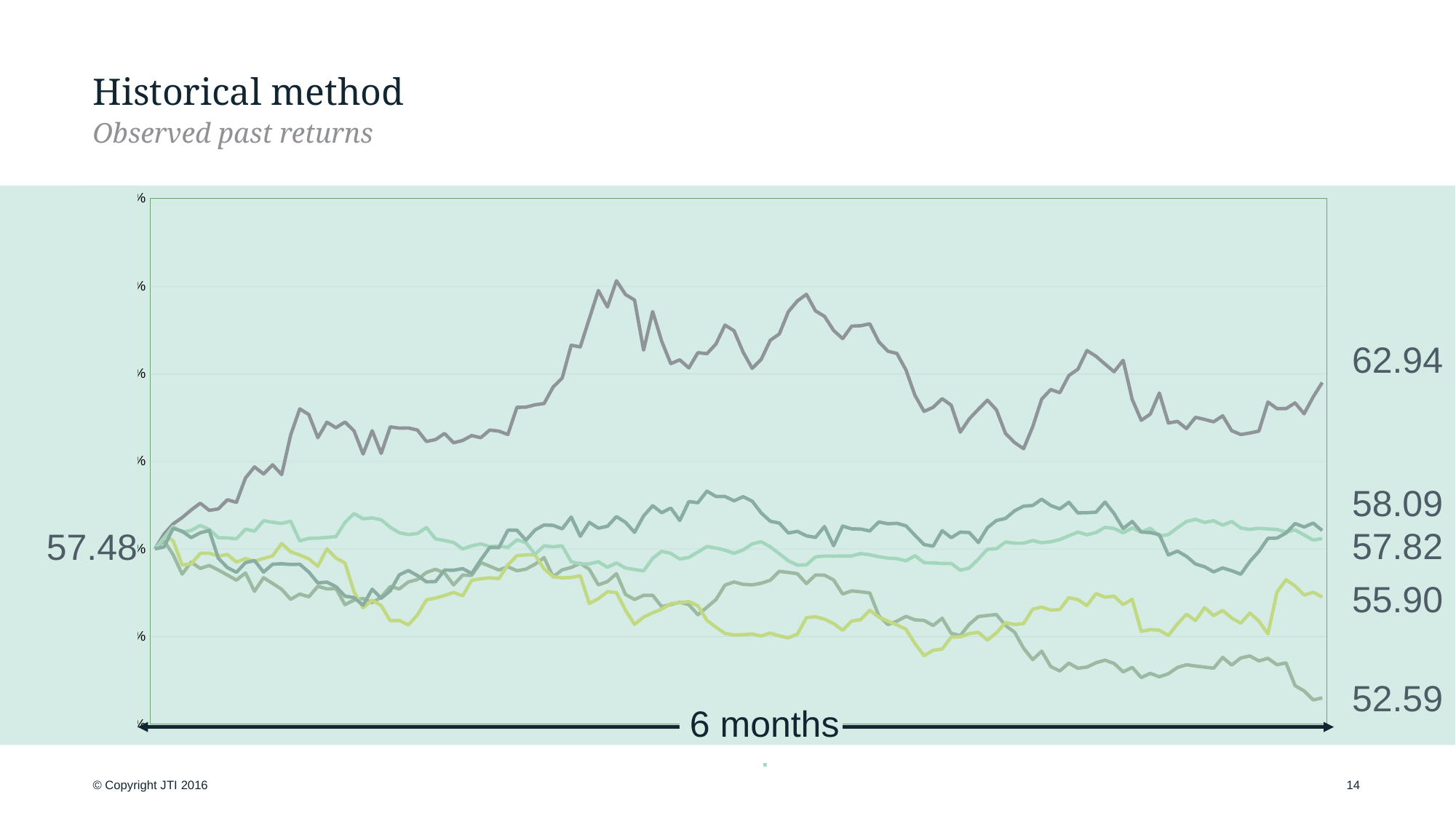
What time span does the horizontal arrow under the chart indicate? 6 months What is the highest end value labelled on the right of the chart? 62.94 Does the line ending at 62.94 rise or fall overall from its start to its end? rise Which end value is larger, 58.09 or 57.82? 58.09 By how much does the top line's end value of 62.94 exceed the starting value of 57.48? 5.46 What is the common starting value of the lines, as labelled on the left of the chart? 57.48 Does the line ending at 52.59 finish above or below its starting value of 57.48? below How many lines are plotted on the chart? 5 What is the difference between the highest end value (62.94) and the lowest end value (52.59)? 10.35 What kind of chart is shown on the slide? line chart What is the title of the slide containing the chart? Historical method What is the lowest end value labelled on the right of the chart? 52.59